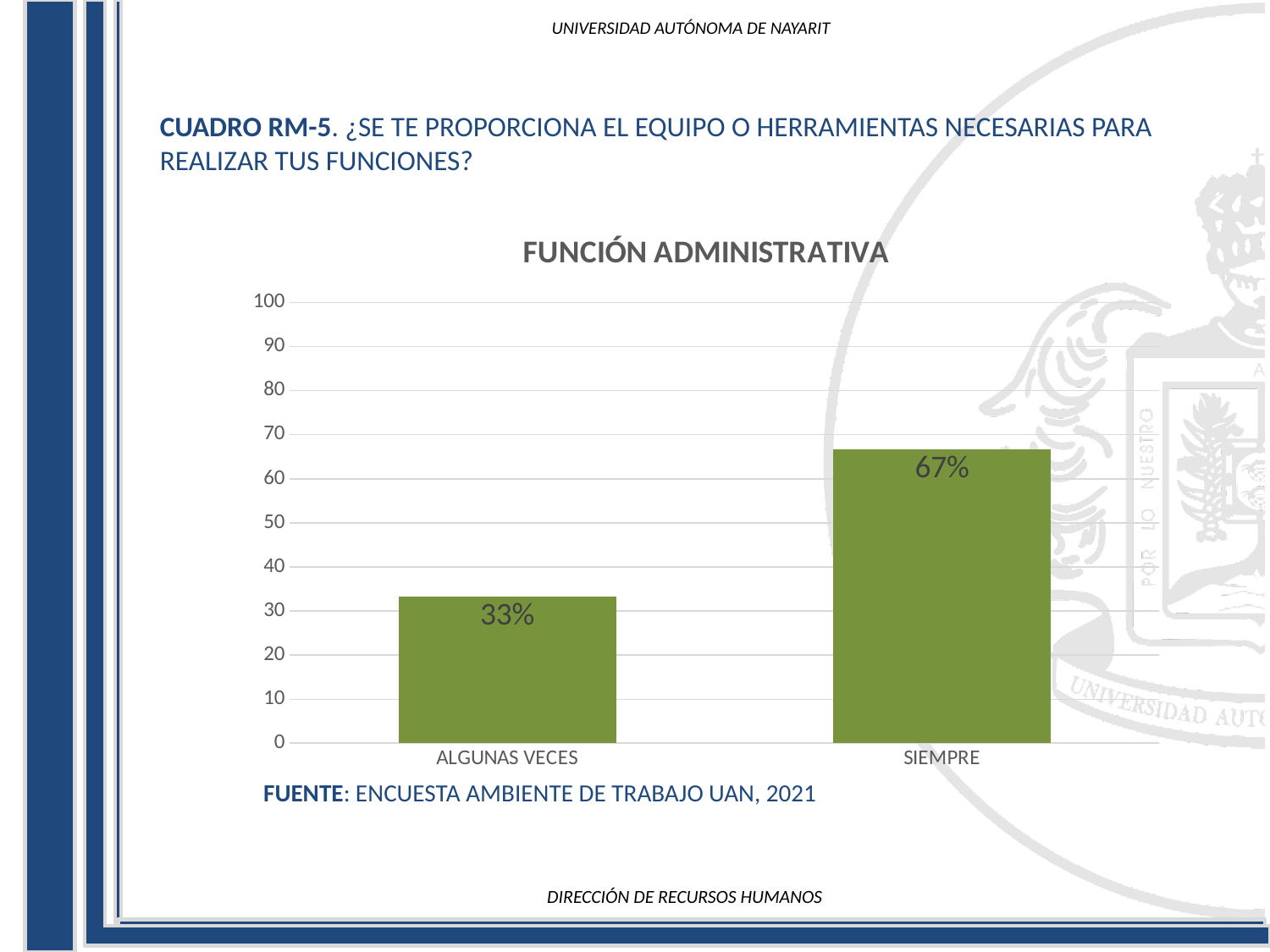
What is the title of the chart? FUNCIÓN ADMINISTRATIVA What is the difference between the values for SIEMPRE and ALGUNAS VECES? 34% What is the value for ALGUNAS VECES? 33% How many categories are shown on the x axis? 2 What kind of chart is shown on the slide? bar chart Which category has the lowest value? ALGUNAS VECES Is the value for SIEMPRE greater or less than 50? greater Which category has the highest value? SIEMPRE Which is larger, the value for ALGUNAS VECES or the value for SIEMPRE? SIEMPRE What is the value for SIEMPRE? 67% Is the value for ALGUNAS VECES greater or less than 40? less What is the highest value shown on the y axis? 100